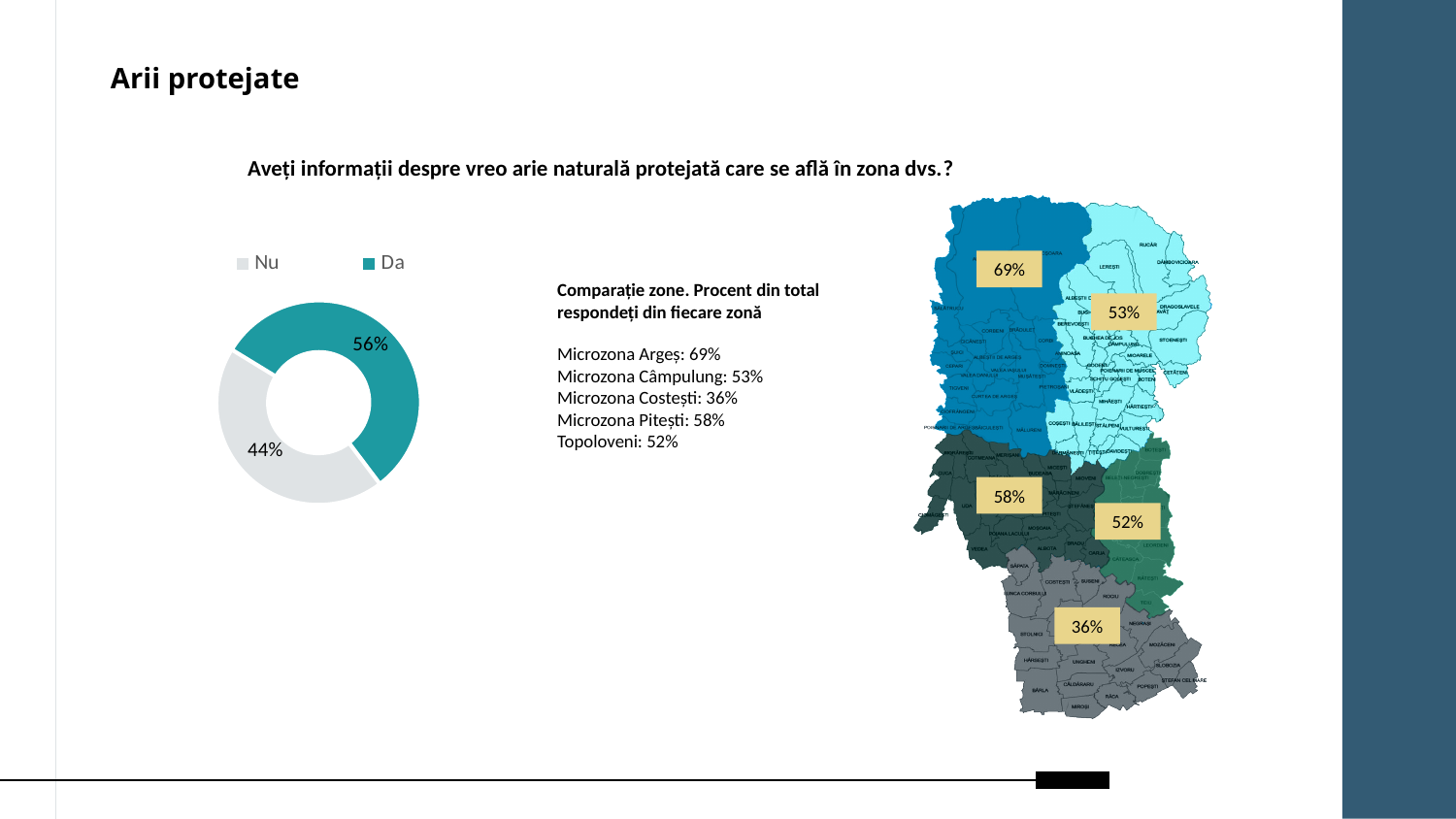
In the donut chart, what is the difference in percentage points between "Da" and "Nu"? 12 percentage points On the map on the right, which zone has the lowest percentage label? The southern (grey) zone, 36% In the donut chart, what percentage of respondents answered "Da"? 56% In the donut chart, which answer has the larger share, "Nu" or "Da"? Da On the map on the right, what percentage is shown for the light blue zone in the north-east? 53% How many categories does the donut chart's legend list? 2 In the donut chart, what colour is the "Da" slice? Teal What type of chart is shown on the left of the slide? Donut (pie) chart On the map on the right, what percentage is shown for the northern-most (dark blue) zone? 69% In the donut chart, which category has the smallest share? Nu What question is the donut chart answering, as written above it? Aveți informații despre vreo arie naturală protejată care se află în zona dvs.? In the donut chart, what percentage of respondents answered "Nu"? 44%